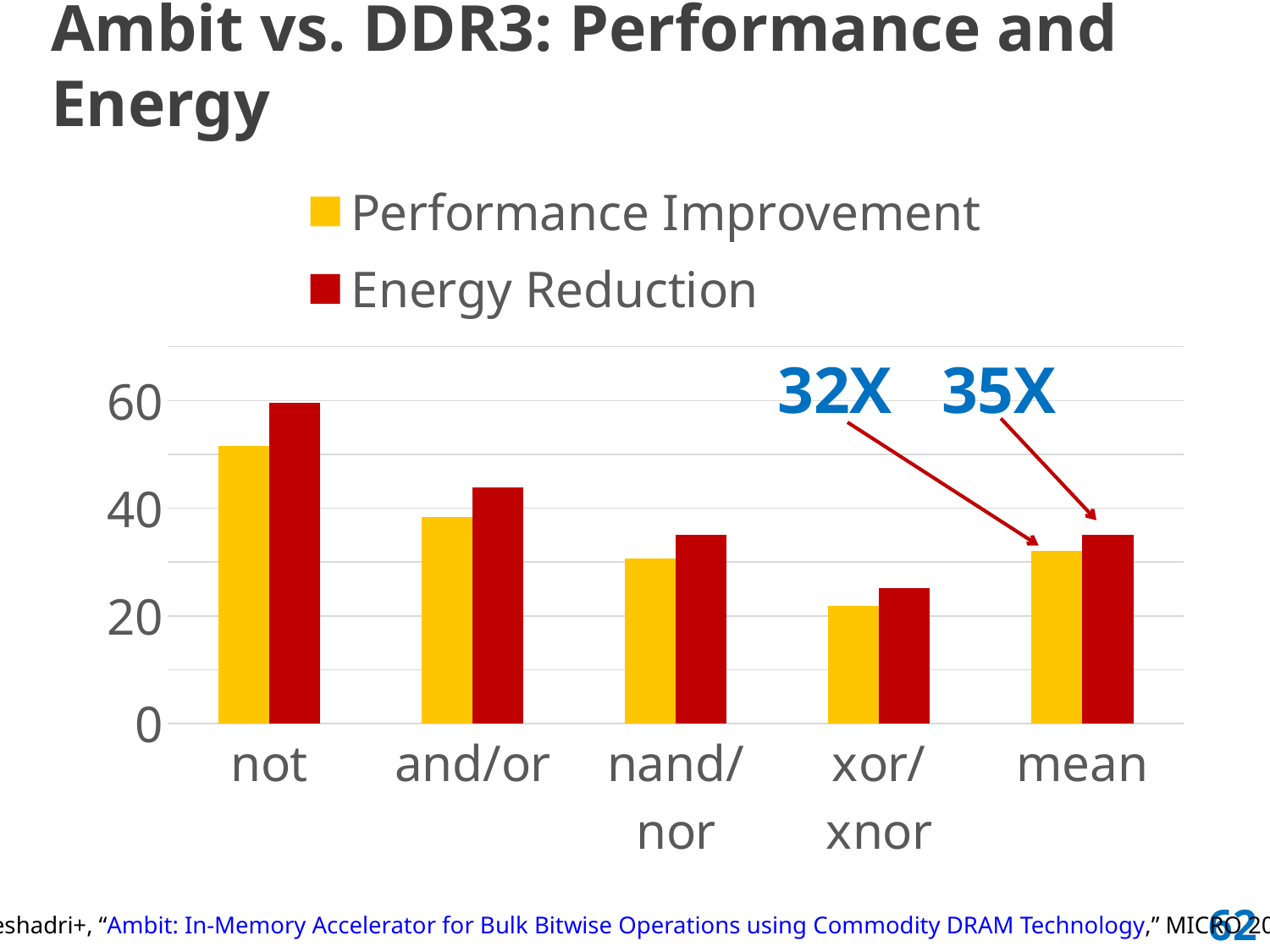
Do the Performance Improvement values rise or fall from not to xor/xnor? fall Which is larger, the Energy Reduction for not or for and/or? not What kind of chart is shown on the slide? bar chart What is the Performance Improvement value for the mean category? 32X What is the Energy Reduction value for the mean category? 35X Which category has the highest Energy Reduction? not Which category has the lowest Performance Improvement? xor/xnor How many categories are shown on the x axis? 5 Is the Energy Reduction value for xor/xnor greater or less than 40? less Is the Performance Improvement value for not greater or less than 40? greater How many series does the legend list? 2 What is the difference between the Energy Reduction and Performance Improvement values for the mean category? 3X